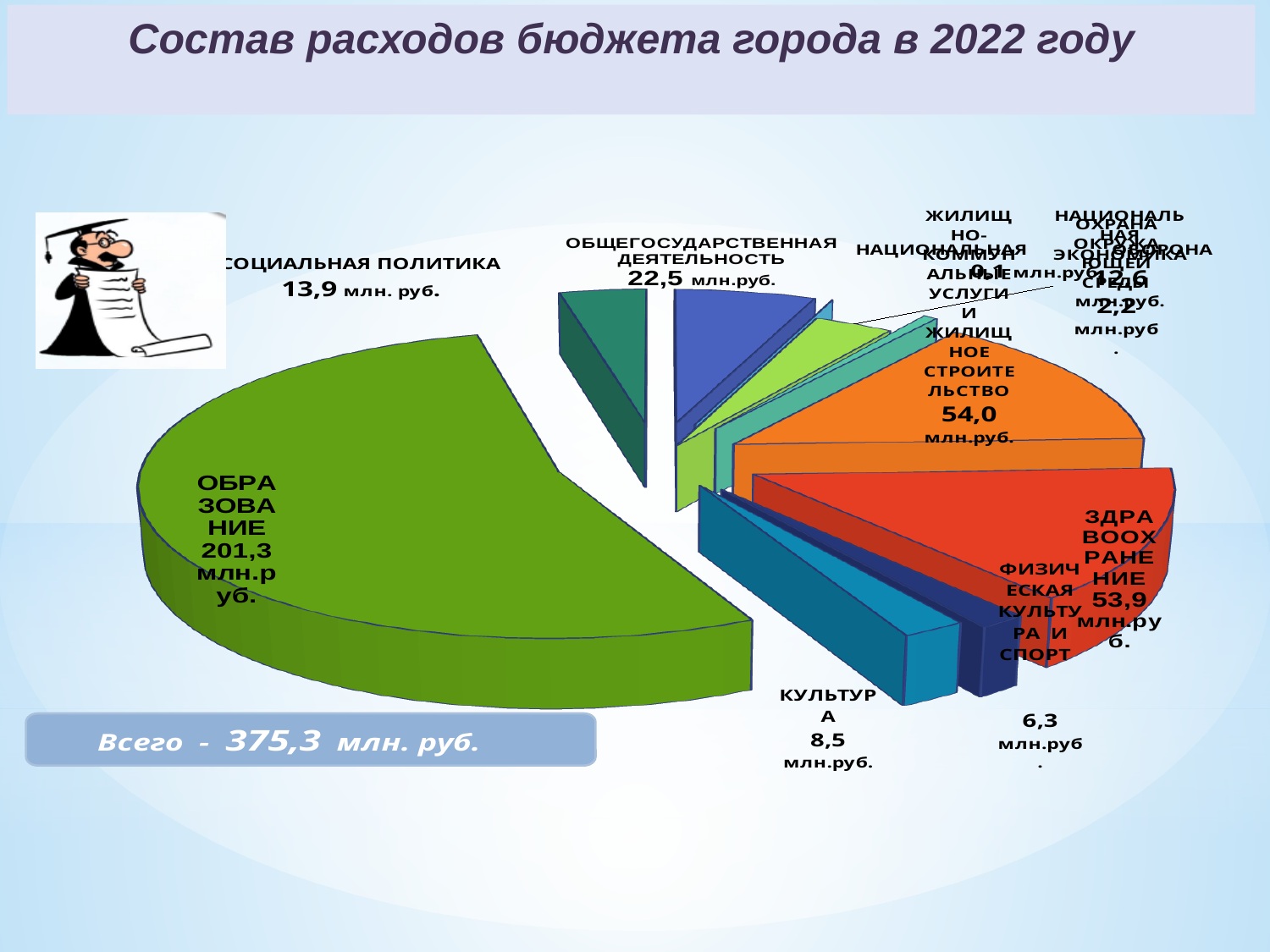
What is the value for Культура? 8,5 млн.руб. What kind of chart is shown on the slide? pie chart What is the difference between the values for Образование and Здравоохранение? 147,4 млн.руб. What is the title of the chart? Состав расходов бюджета города в 2022 году Which is larger, the value for Общегосударственная деятельность or the value for Социальная политика? Общегосударственная деятельность What is the value for Здравоохранение? 53,9 млн.руб. What is the value for Социальная политика? 13,9 млн. руб. What is the total of all budget expenses shown on the slide? 375,3 млн. руб. What is the value for Физическая культура и спорт? 6,3 млн.руб. What is the value for Общегосударственная деятельность? 22,5 млн.руб. Which category has the largest share of the budget expenses? Образование What is the value for Образование? 201,3 млн.руб.